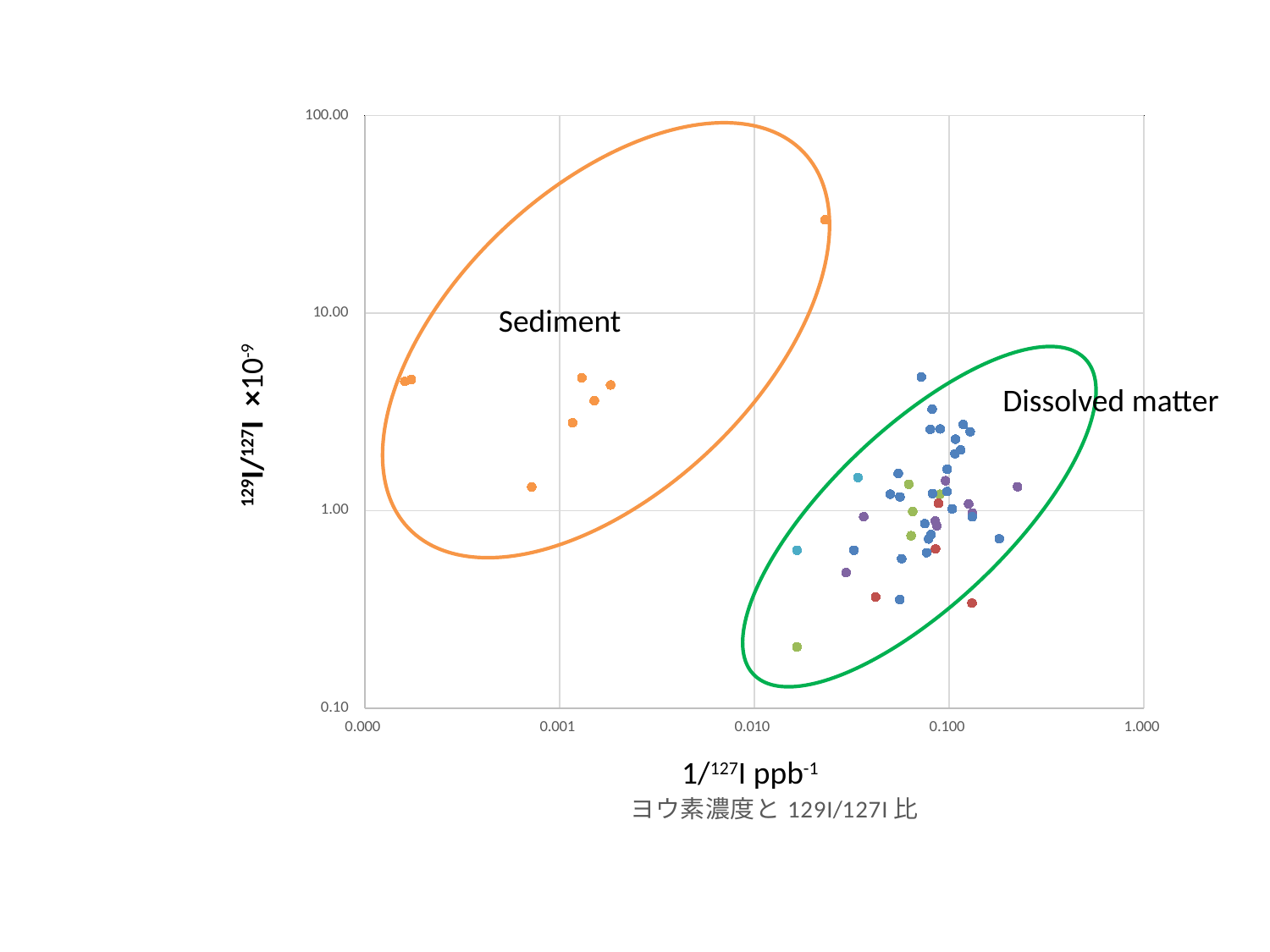
Are all the Dissolved matter points greater or less than 10.00 on the y axis? less Is the lowest Dissolved matter point greater or less than 1.00 on the y axis? less Are all the Sediment points greater or less than 1.00 on the y axis? greater What is the maximum value shown on the y axis? 100.00 Which group, Sediment or Dissolved matter, has the larger values on the x axis (1/127I)? Dissolved matter Which group contains the point with the highest 129I/127I value on the chart? Sediment Which group contains the point with the lowest 129I/127I value on the chart? Dissolved matter What kind of chart is shown on the slide? Scatter chart How many labelled groups of points are circled on the chart? 2 What are the two labelled groups of points on the chart? Sediment and Dissolved matter What colour is the ellipse drawn around the Dissolved matter points? Green